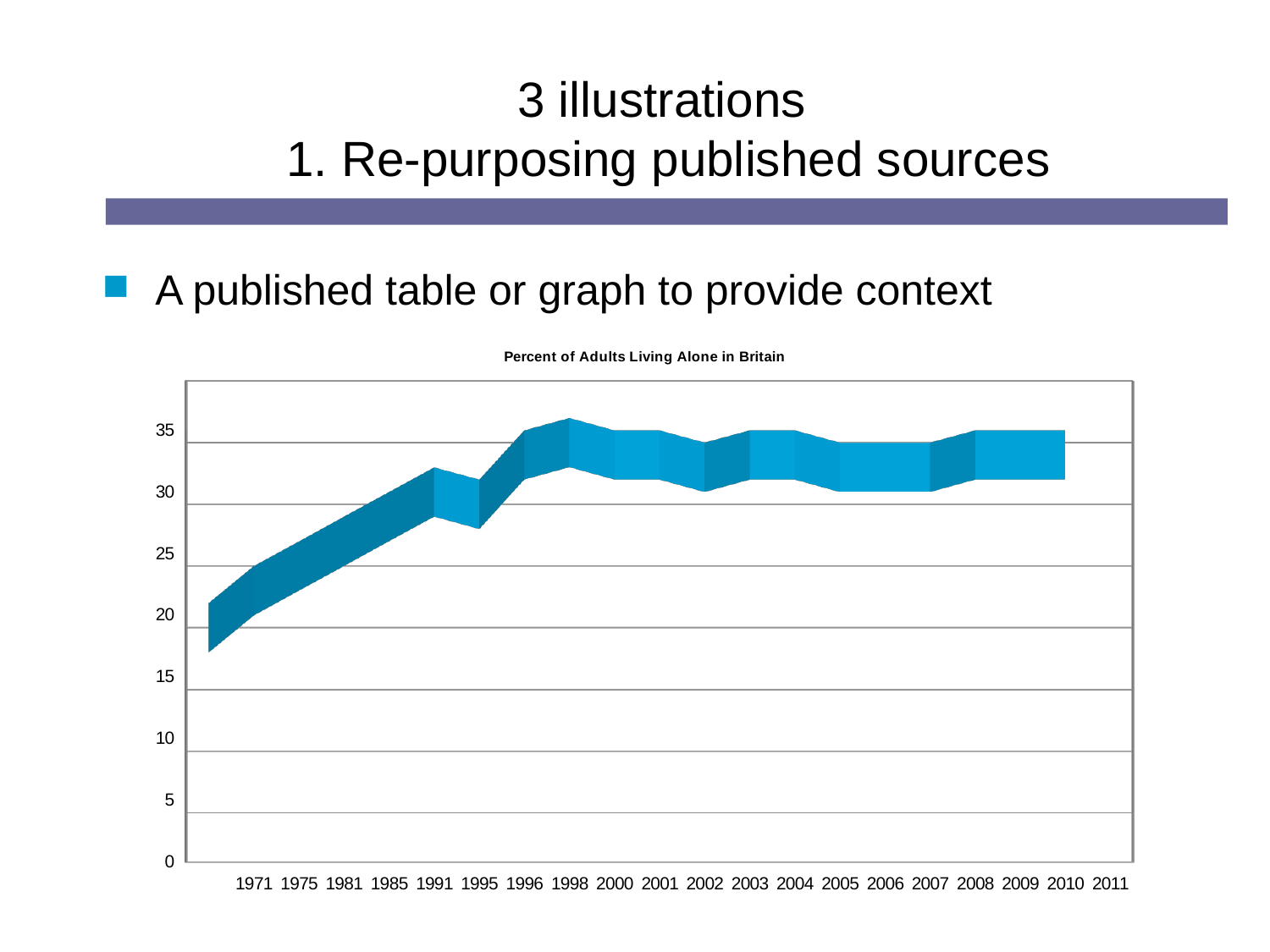
What kind of chart is shown on the slide? line chart Is the value for 1985 greater or less than 20? greater Which is larger, the value for 1991 or the value for 1995? 1991 Do the values generally rise or fall from 1971 to 1998? rise Is the value for 2010 greater or less than 30? greater Is the value for 1971 greater or less than 25? less What is the title of the chart? Percent of Adults Living Alone in Britain Which is larger, the value for 1971 or the value for 2010? 2010 Which year has the highest percent of adults living alone? 1998 Which year has the lowest percent of adults living alone? 1971 What is the highest value labelled on the vertical axis? 35